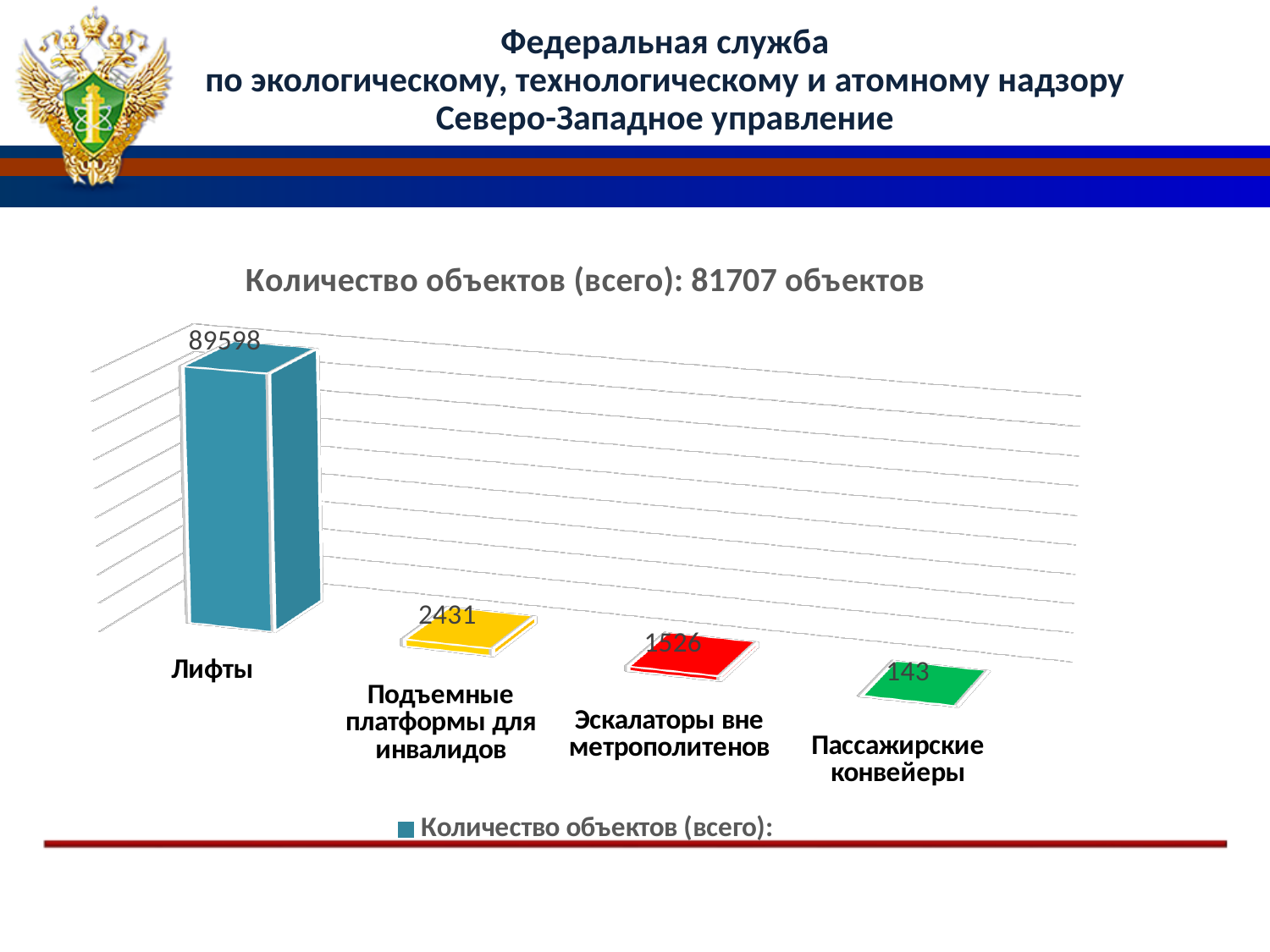
What is the value shown for Лифты? 89598 What is the value shown for Подъемные платформы для инвалидов? 2431 What is the value shown for Пассажирские конвейеры? 143 Which category has the lowest value? Пассажирские конвейеры Which category has the highest value? Лифты Which is larger, the value for Эскалаторы вне метрополитенов or the value for Пассажирские конвейеры? Эскалаторы вне метрополитенов How many categories are shown in the chart? 4 What is the title of the chart? Количество объектов (всего): 81707 объектов What is the value shown for Эскалаторы вне метрополитенов? 1526 What is the difference between the values for Подъемные платформы для инвалидов and Эскалаторы вне метрополитенов? 905 What kind of chart is shown on the slide? Bar chart How many series does the legend list? 1